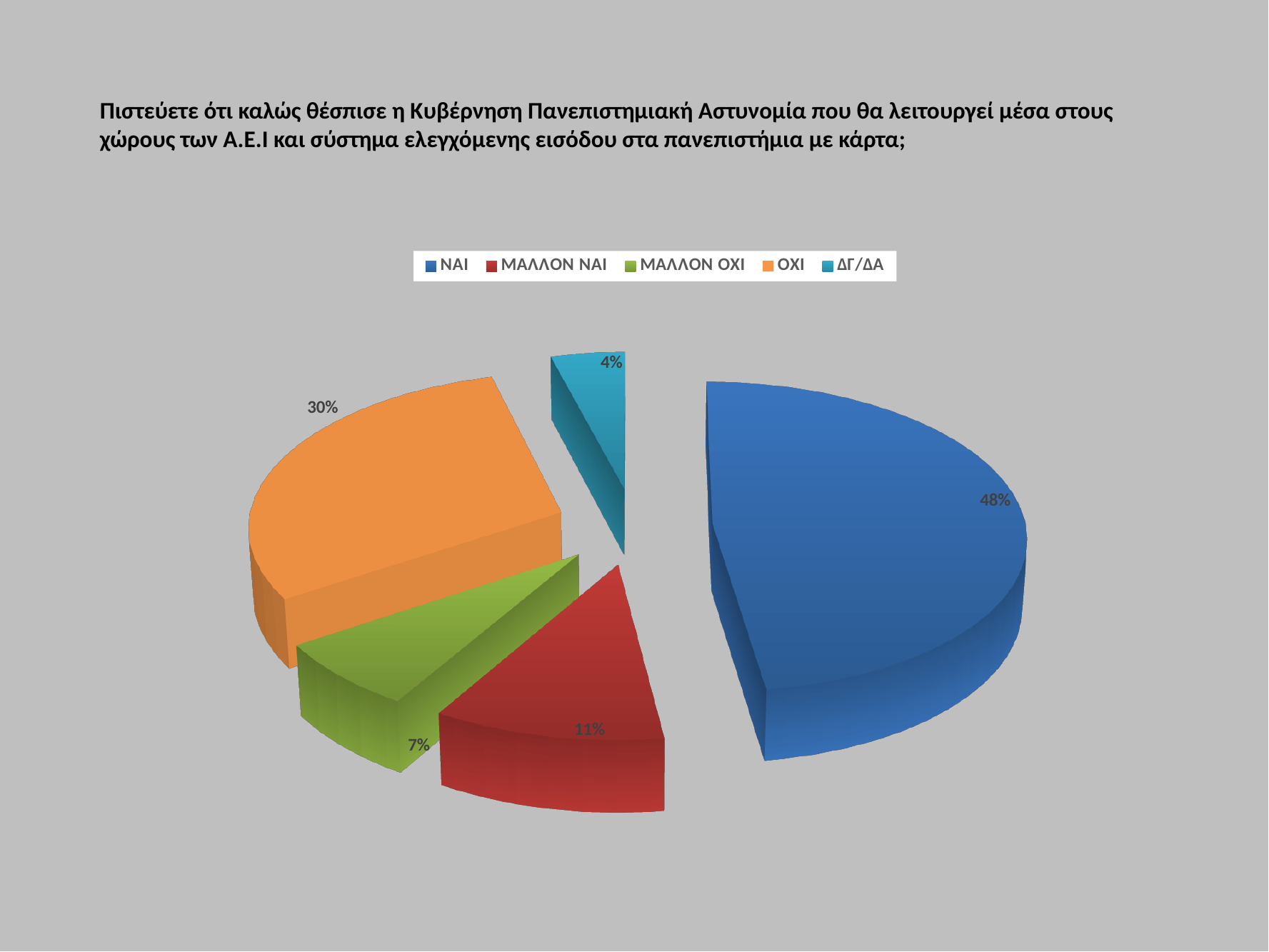
Which category has the largest share of the pie? ΝΑΙ How many categories does the legend list? 5 What is the difference in percentage points between the ΝΑΙ and ΟΧΙ slices? 18 What kind of chart is shown on the slide? pie chart Which is larger, the ΜΑΛΛΟΝ ΝΑΙ slice or the ΜΑΛΛΟΝ ΟΧΙ slice? ΜΑΛΛΟΝ ΝΑΙ What colour is the ΟΧΙ slice? orange What percentage of the pie is the ΜΑΛΛΟΝ ΟΧΙ slice? 7% What percentage of the pie is the ΟΧΙ slice? 30% What percentage of the pie is the ΝΑΙ slice? 48% Which category has the smallest share of the pie? ΔΓ/ΔΑ What percentage of the pie is the ΔΓ/ΔΑ slice? 4% What percentage of the pie is the ΜΑΛΛΟΝ ΝΑΙ slice? 11%